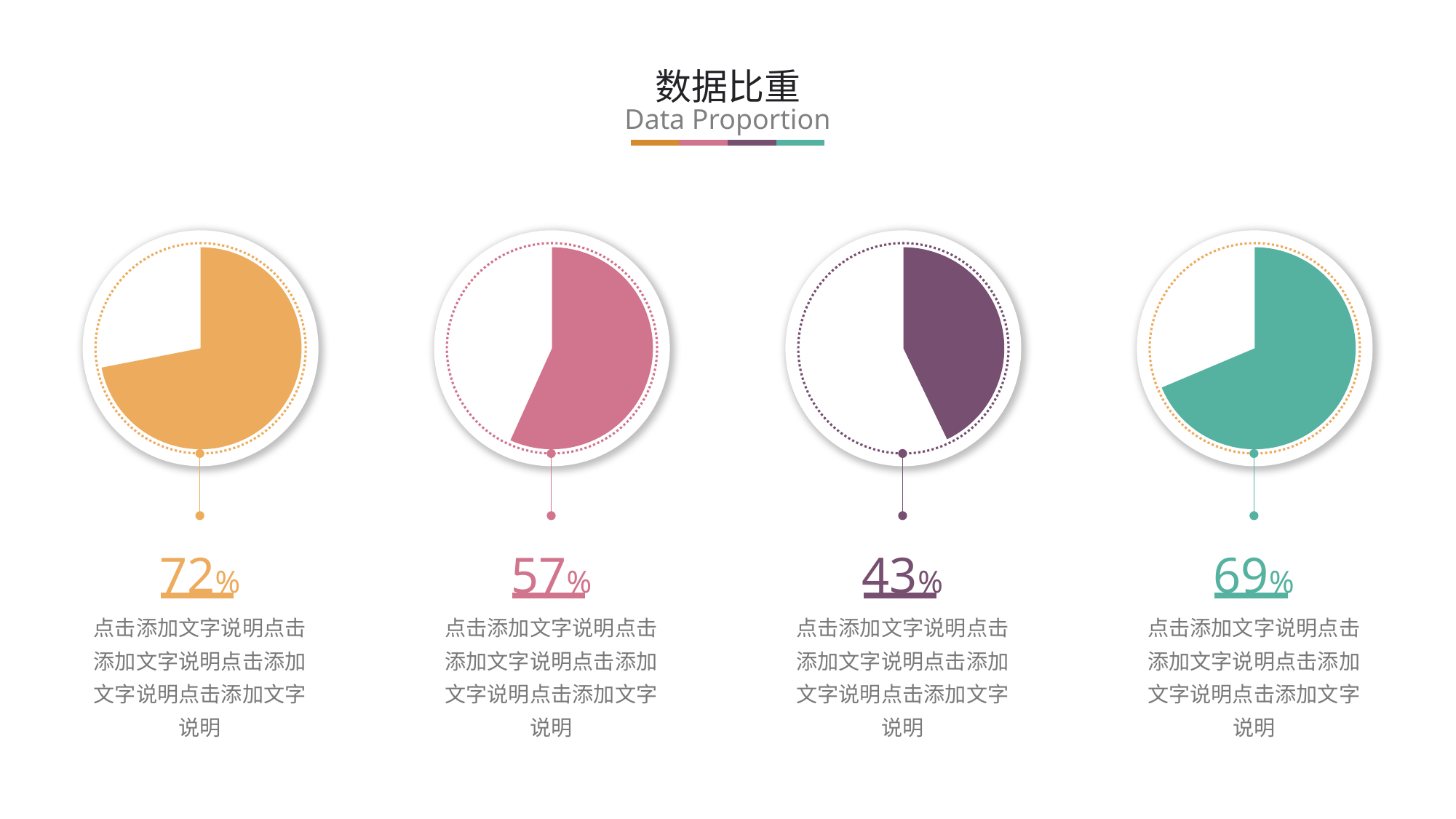
What is the difference between the percentage of the pink chart and the purple chart? 14% What percentage is shown below the second pie chart from the left (pink)? 57% What is the English subtitle of the slide? Data Proportion What percentage is shown below the third pie chart from the left (purple)? 43% Which of the four pie charts shows the highest percentage? The leftmost (orange) chart, 72% Which is larger, the percentage of the pink chart or the percentage of the green chart? The green chart (69%) How many pie charts are shown on the slide? 4 What percentage is shown below the rightmost (green) pie chart? 69% What percentage is shown below the leftmost (orange) pie chart? 72% What is the difference between the percentage of the leftmost (orange) chart and the rightmost (green) chart? 3% What kind of chart is used to show each percentage on the slide? Pie chart Which of the four pie charts shows the lowest percentage? The third from the left (purple) chart, 43%